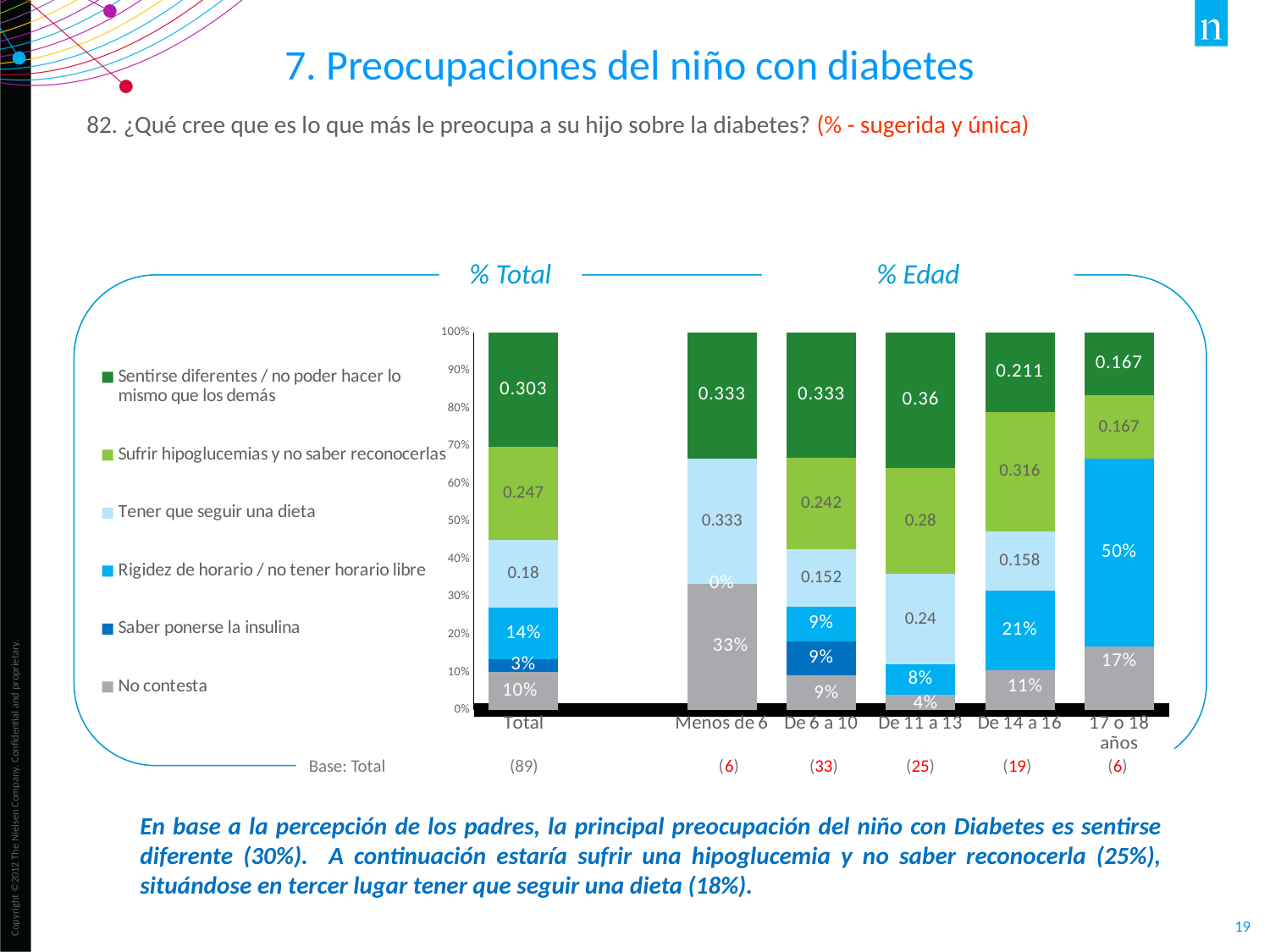
How many series does the legend list? 6 What is the base (number of respondents) shown for the 'De 6 a 10' category? 33 What is the value for 'Tener que seguir una dieta' in the 'De 11 a 13' bar? 0.24 What is the value for 'Saber ponerse la insulina' in the Total bar? 3% How many categories are shown along the x axis? 6 What kind of chart is shown on the slide? stacked bar chart What is the value for 'Sufrir hipoglucemias y no saber reconocerlas' in the Total bar? 0.247 What is the value for 'No contesta' in the 'Menos de 6' bar? 33% Which age category has the highest value for 'Sentirse diferentes / no poder hacer lo mismo que los demás'? De 11 a 13 Which is larger in the 'De 14 a 16' bar: 'Sufrir hipoglucemias y no saber reconocerlas' or 'Sentirse diferentes / no poder hacer lo mismo que los demás'? Sufrir hipoglucemias y no saber reconocerlas What is the value for 'Sentirse diferentes / no poder hacer lo mismo que los demás' in the Total bar? 0.303 What is the value for 'Rigidez de horario / no tener horario libre' in the '17 o 18 años' bar? 50%